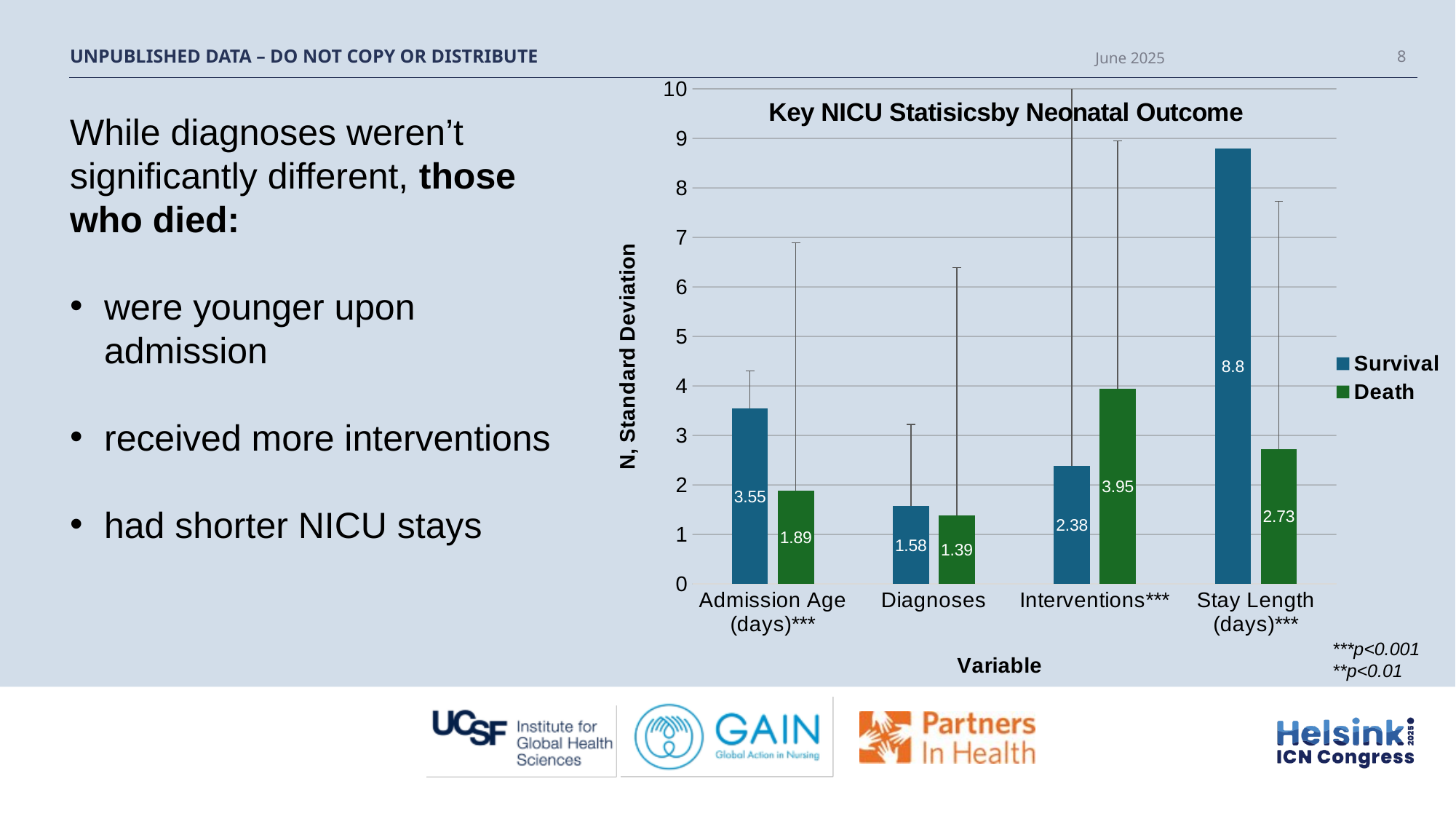
What is the Death value for Interventions***? 3.95 What is the difference between the Survival and Death values for Stay Length (days)***? 6.07 What is the label of the y axis? N, Standard Deviation What is the Death value for Diagnoses? 1.39 Which variable has the highest Survival value? Stay Length (days)*** What kind of chart is shown on the slide? Bar chart Which variable has the lowest Death value? Diagnoses How many series does the legend list? 2 For Interventions***, which series has the larger value, Survival or Death? Death What is the Survival value for Admission Age (days)***? 3.55 What is the Survival value for Stay Length (days)***? 8.8 How many variables are shown on the x axis? 4